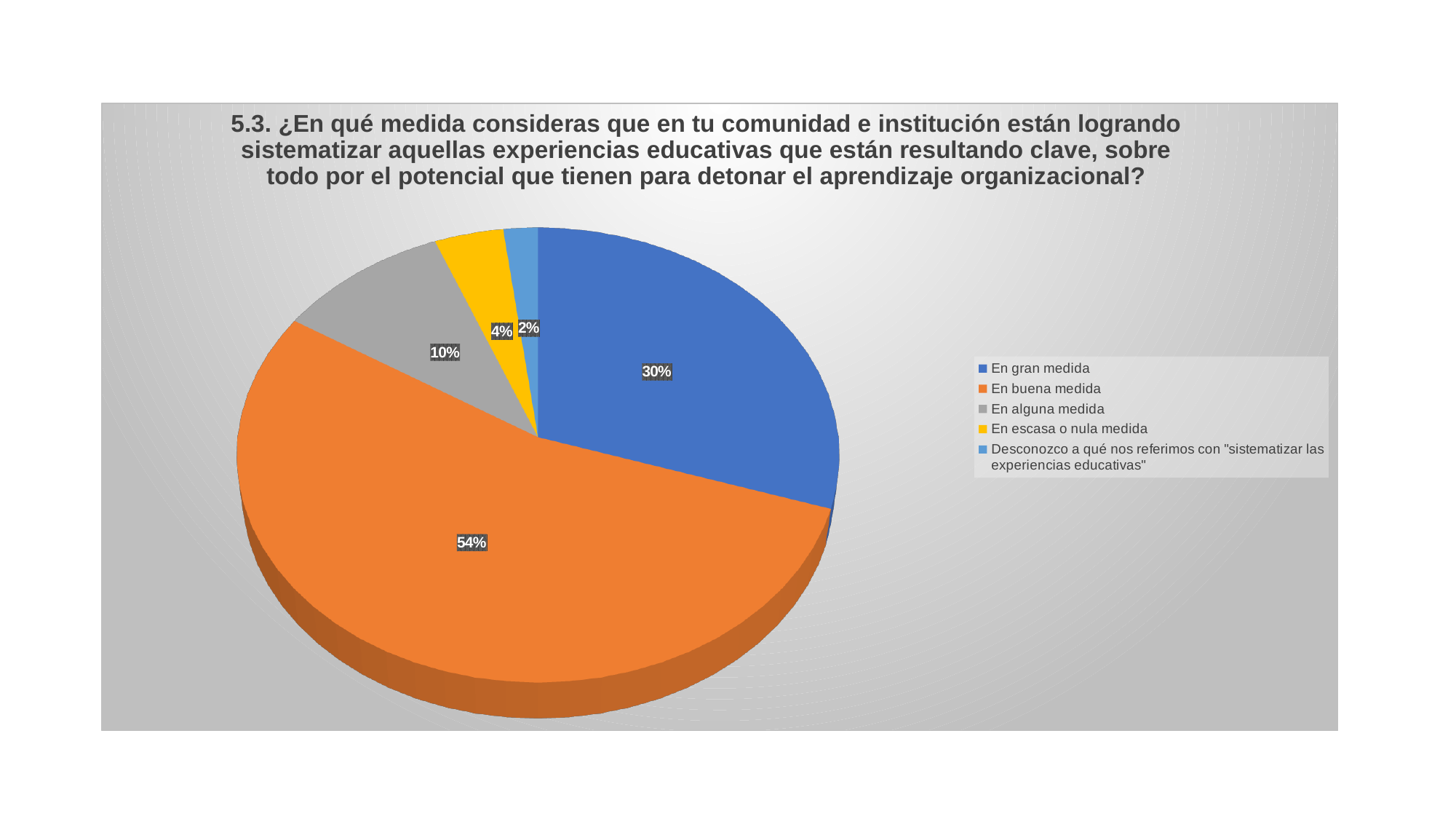
What colour is the slice for "En escasa o nula medida"? Yellow What percentage is shown for "Desconozco a qué nos referimos con "sistematizar las experiencias educativas""? 2% What percentage is shown for "En escasa o nula medida"? 4% What type of chart is shown on the slide? Pie chart What percentage is shown for "En buena medida"? 54% How many categories does the legend list? 5 What percentage is shown for "En alguna medida"? 10% What is the difference in percentage points between "En buena medida" and "En gran medida"? 24 Which category has the largest slice of the pie? En buena medida Which is larger, the slice for "En alguna medida" or the slice for "En escasa o nula medida"? En alguna medida Which category has the smallest slice of the pie? Desconozco a qué nos referimos con "sistematizar las experiencias educativas" What percentage is shown for "En gran medida"? 30%